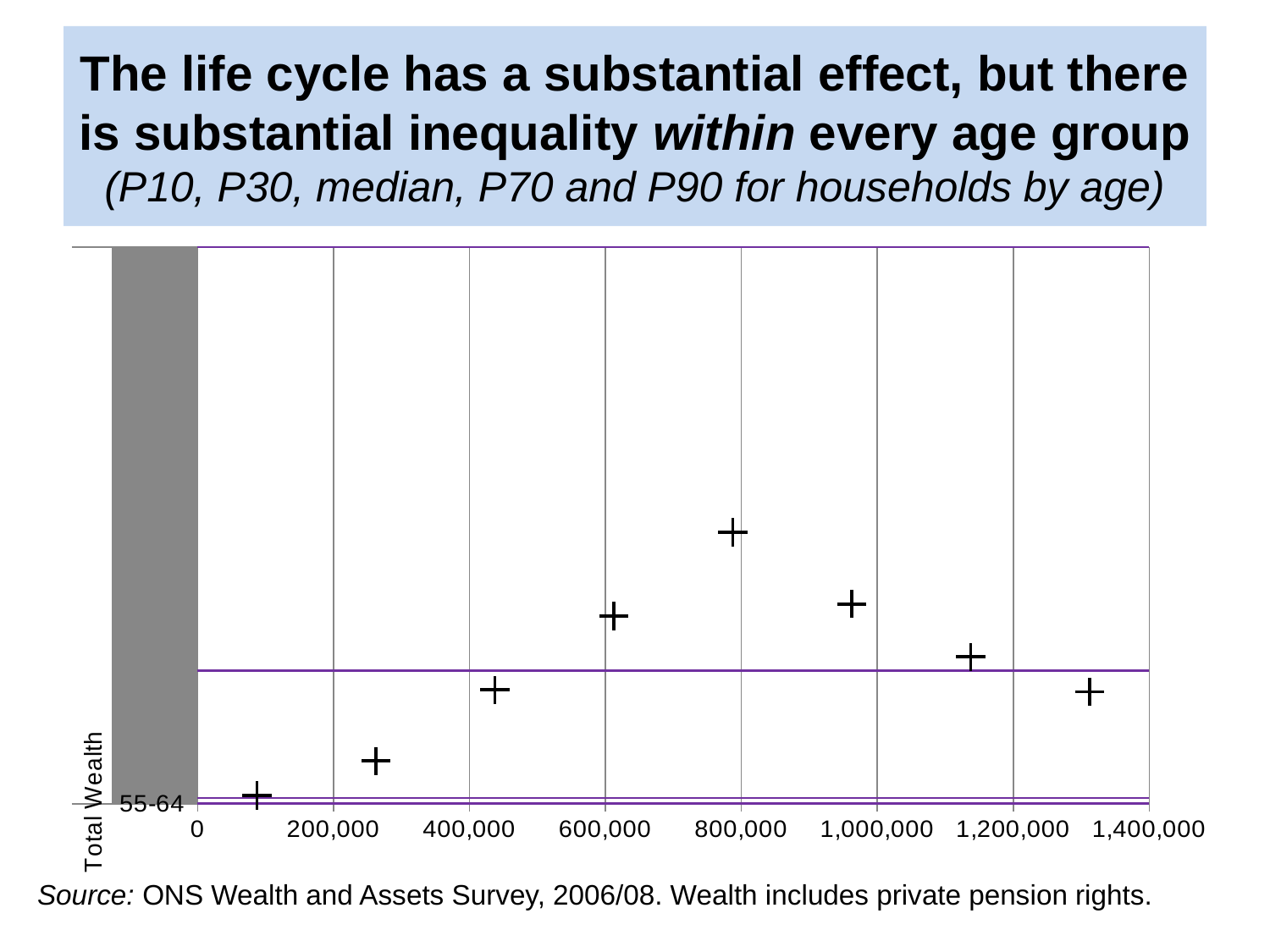
Is the horizontal position of the rightmost plus marker greater or less than 1,200,000? greater What is the title of the vertical axis on the chart? Total Wealth Which age group label is shown on the chart's vertical axis? 55-64 What is the spacing between consecutive tick labels on the horizontal axis? 200,000 Is the horizontal position of the leftmost plus marker greater or less than 200,000? less How many plus-shaped markers are plotted on the chart? 8 What is the largest value labelled on the horizontal axis of the chart? 1,400,000